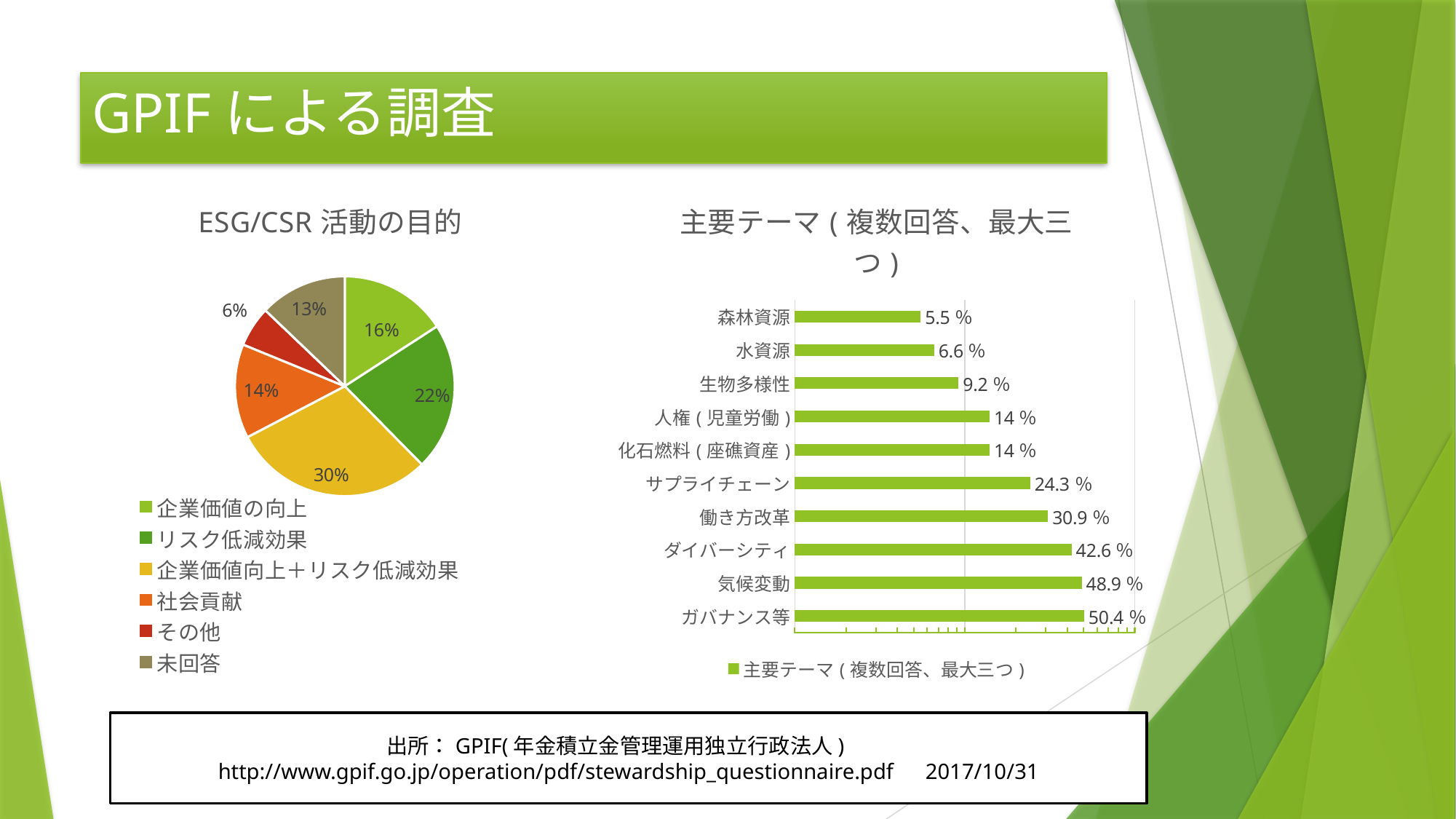
In the bar chart titled 主要テーマ（複数回答、最大三つ）, which category has the lowest value? 森林資源 In the bar chart titled 主要テーマ（複数回答、最大三つ）, how many categories are plotted? 10 In the bar chart titled 主要テーマ（複数回答、最大三つ）, which category has the highest value? ガバナンス等 In the bar chart titled 主要テーマ（複数回答、最大三つ）, what is the value for 生物多様性? 9.2 % In the bar chart titled 主要テーマ（複数回答、最大三つ）, what is the value for 気候変動? 48.9 % In the pie chart titled ESG/CSR 活動の目的, which category has the smallest slice? その他 In the bar chart titled 主要テーマ（複数回答、最大三つ）, which is larger, the value for ダイバーシティ or the value for 働き方改革? ダイバーシティ In the pie chart titled ESG/CSR 活動の目的, what is the difference between the shares for リスク低減効果 and 企業価値の向上? 6% In the pie chart titled ESG/CSR 活動の目的, what share is shown for 企業価値向上＋リスク低減効果? 30% In the pie chart titled ESG/CSR 活動の目的, which category has the largest slice? 企業価値向上＋リスク低減効果 What kind of chart is the one titled 主要テーマ（複数回答、最大三つ）? Bar chart In the pie chart titled ESG/CSR 活動の目的, how many categories does the legend list? 6